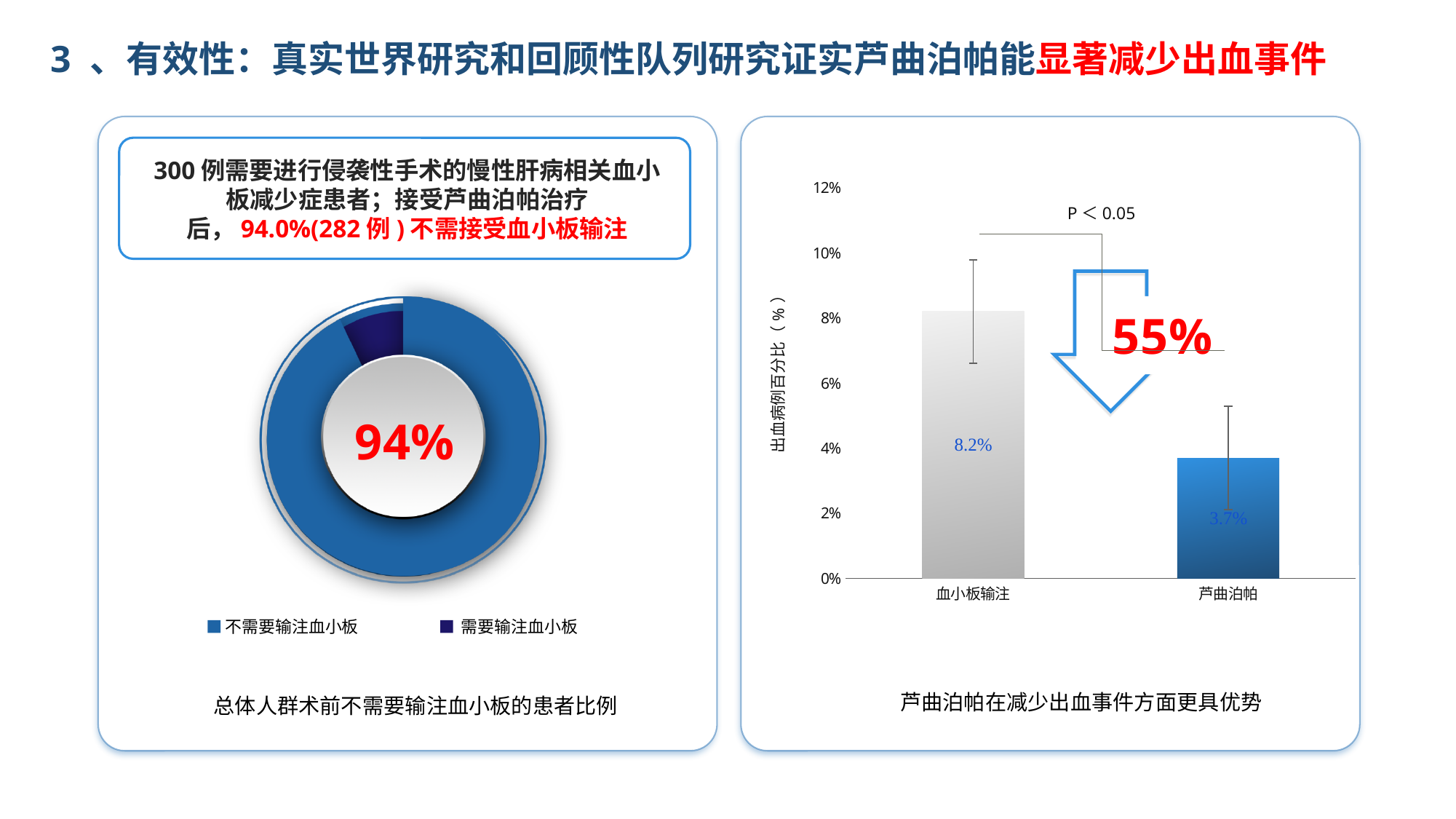
In the left chart, what colour is the 需要输注血小板 slice? Dark navy blue In the right chart, how many categories are shown on the x axis? 2 In the right chart, what is the difference between the values for 血小板输注 and 芦曲泊帕? 4.5% In the right chart, what is the y-axis label? 出血病例百分比（%） In the left chart, what share of patients is labelled for 不需要输注血小板? 94% In the right chart (芦曲泊帕在减少出血事件方面更具优势), what kind of chart is shown? Bar chart In the right chart, what is the value for 血小板输注? 8.2% In the left chart, which slice is larger, 不需要输注血小板 or 需要输注血小板? 不需要输注血小板 In the right chart, what is the value for 芦曲泊帕? 3.7% In the left chart, how many entries does the legend list? 2 In the right chart, which category has the highest value? 血小板输注 In the left chart (总体人群术前不需要输注血小板的患者比例), what kind of chart is shown? Pie (donut) chart